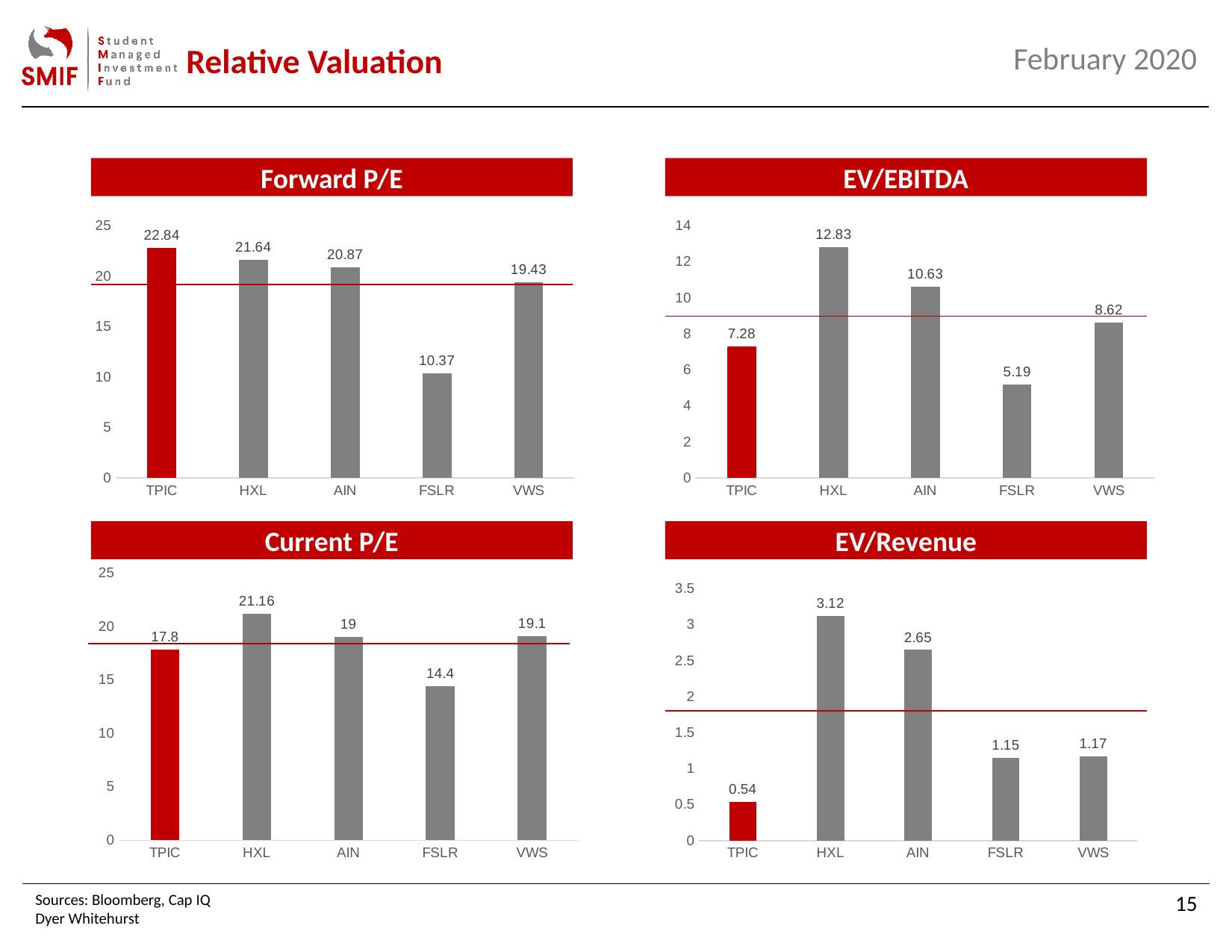
In the EV/EBITDA chart, what is the value for AIN? 10.63 In the EV/EBITDA chart, which company has the highest value? HXL In the EV/Revenue chart, which company has the lowest value? TPIC In the Current P/E chart, which is larger, the value for HXL or the value for VWS? HXL In the Current P/E chart, what is the value for FSLR? 14.4 In the EV/EBITDA chart, what is the difference between HXL and TPIC? 5.55 In the EV/Revenue chart, is the value for AIN greater or less than 2? greater In the EV/Revenue chart, what is the value for TPIC? 0.54 What kind of chart is the Current P/E chart? Bar chart In the Forward P/E chart, what is the value for TPIC? 22.84 How many companies are shown in the Forward P/E chart? 5 In the Forward P/E chart, which company has the lowest value? FSLR